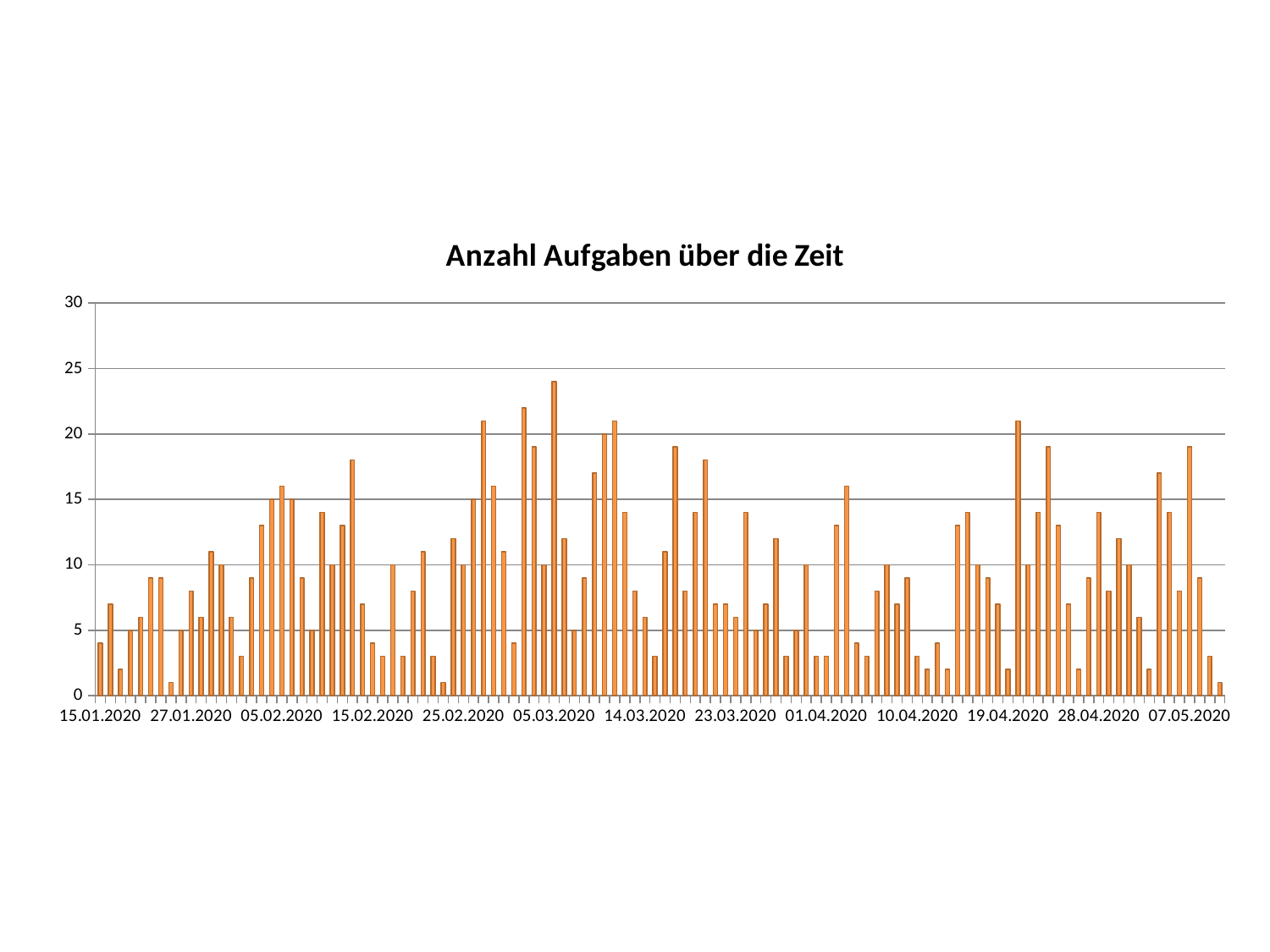
Is the tallest bar in the chart greater or less than 25? less What is the first date label on the horizontal axis? 15.01.2020 What is the title of the chart? Anzahl Aufgaben über die Zeit Is the tallest bar in the chart greater or less than 20? greater What kind of chart is shown on the slide? bar chart Does the chart show a legend? No What is the highest value shown on the vertical axis? 30 What is the last date label on the horizontal axis? 07.05.2020 Is the value for 15.01.2020 greater or less than 5? less How many date labels are printed along the horizontal axis? 13